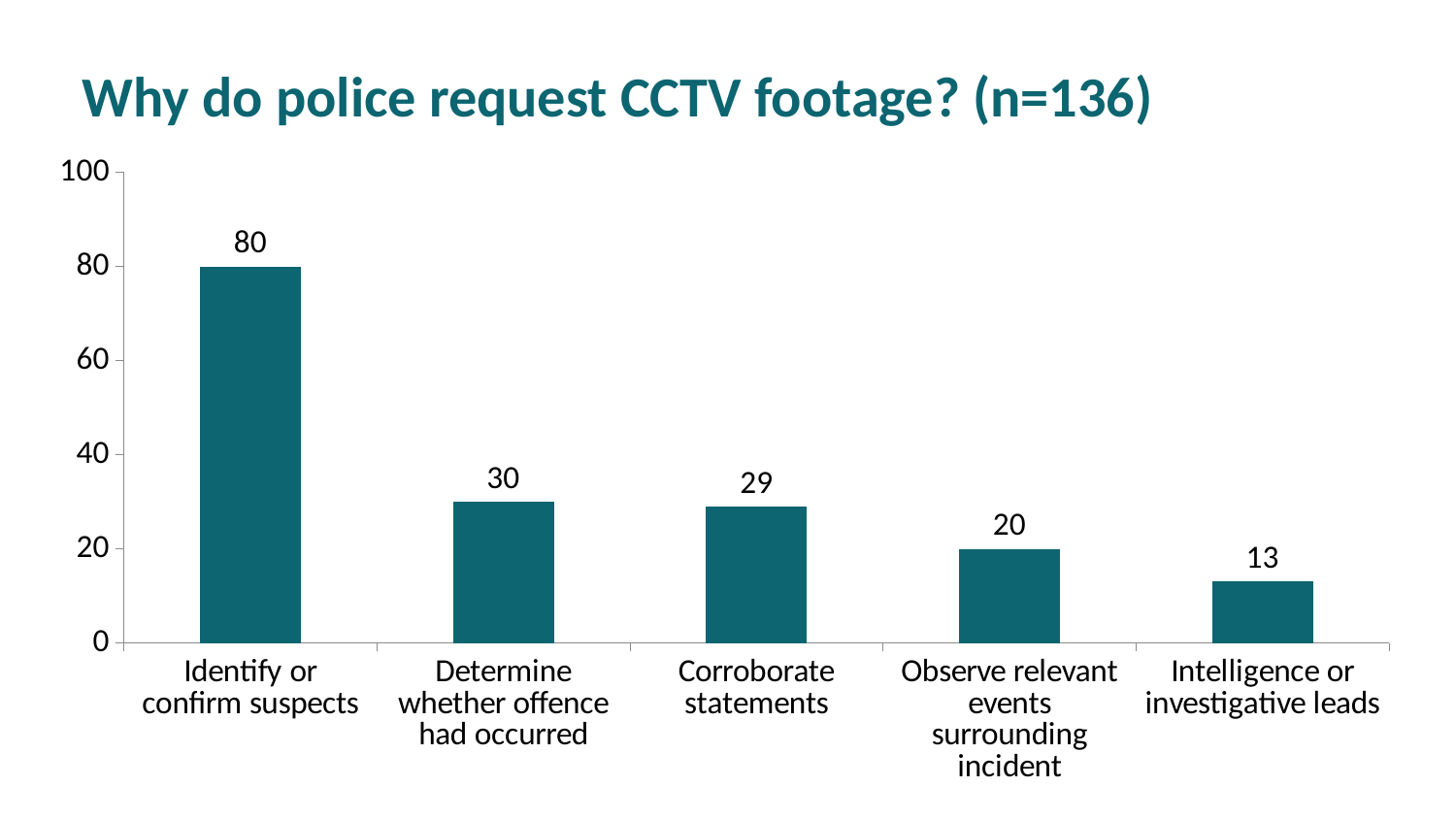
What is the value for "Intelligence or investigative leads"? 13 What is the value for "Corroborate statements"? 29 Which category has the highest value? Identify or confirm suspects Which is larger, the value for "Determine whether offence had occurred" or the value for "Observe relevant events surrounding incident"? Determine whether offence had occurred Which category has the lowest value? Intelligence or investigative leads What is the title of the chart? Why do police request CCTV footage? (n=136) Is the value for "Identify or confirm suspects" greater or less than 60? greater What kind of chart is shown on the slide? Bar chart What is the difference between the values for "Identify or confirm suspects" and "Determine whether offence had occurred"? 50 What is the value for "Identify or confirm suspects"? 80 How many categories are shown on the chart? 5 What is the difference between the values for "Observe relevant events surrounding incident" and "Intelligence or investigative leads"? 7